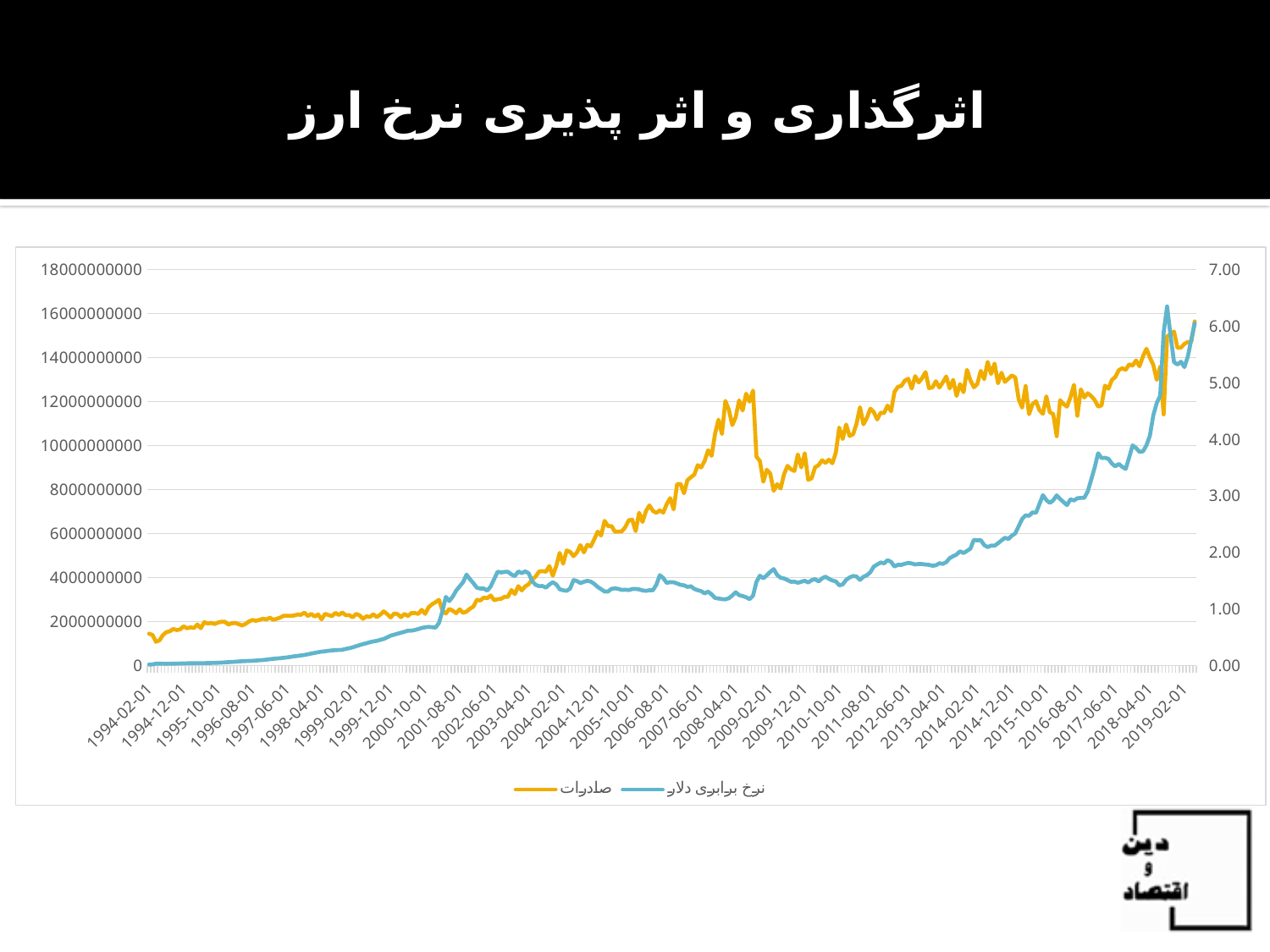
Is the value of صادرات around 2008-04-01 greater or less than 10000000000? greater What is the highest value shown on the left vertical axis? 18000000000 Is the value of صادرات at 1994-02-01 greater or less than 2000000000? less Does the orange line (صادرات) generally rise or fall from 1994-02-01 to 2019-02-01? rise What are the two series named in the legend? صادرات and نرخ برابری دلار What kind of chart is shown on the slide? line chart Is the value of صادرات around 2016-08-01 greater or less than 10000000000? greater How many series does the legend list? 2 Does the blue line (نرخ برابری دلار) generally rise or fall from 1994 to 2019? rise